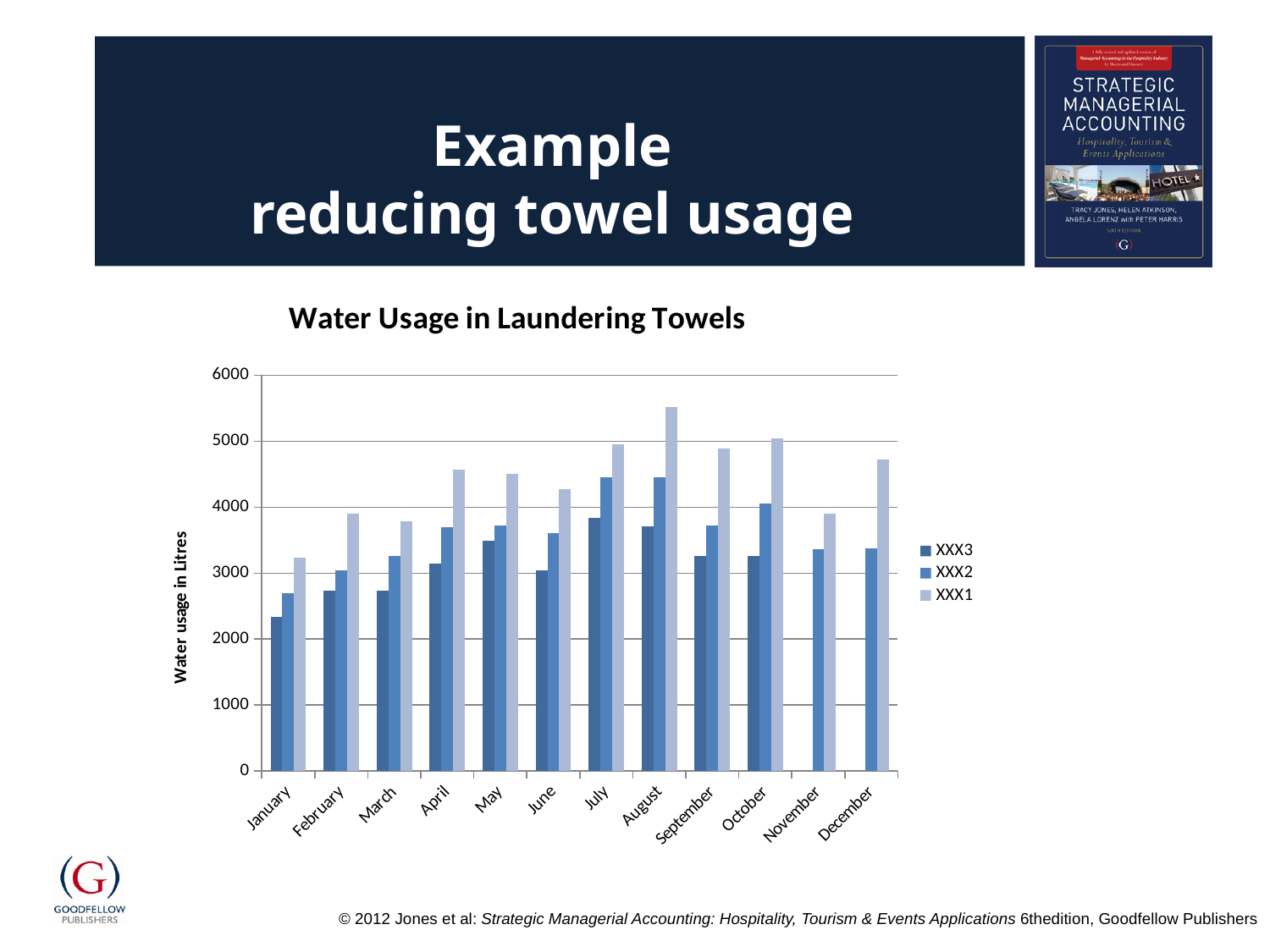
How many months are shown on the x axis? 12 What is the title of the chart? Water Usage in Laundering Towels Is the XXX1 value for August greater or less than 5000? greater In which month is the XXX3 value lowest? January What kind of chart is shown on the slide? Bar chart Which is larger, the XXX1 value for August or the XXX1 value for July? August What is the label on the vertical axis? Water usage in Litres Is the XXX3 value for January greater or less than 3000? less How many series does the legend list? 3 In which month is the XXX1 value highest? August Is the XXX2 value for July greater or less than 4000? greater Does the XXX1 value rise or fall from January to April? rise